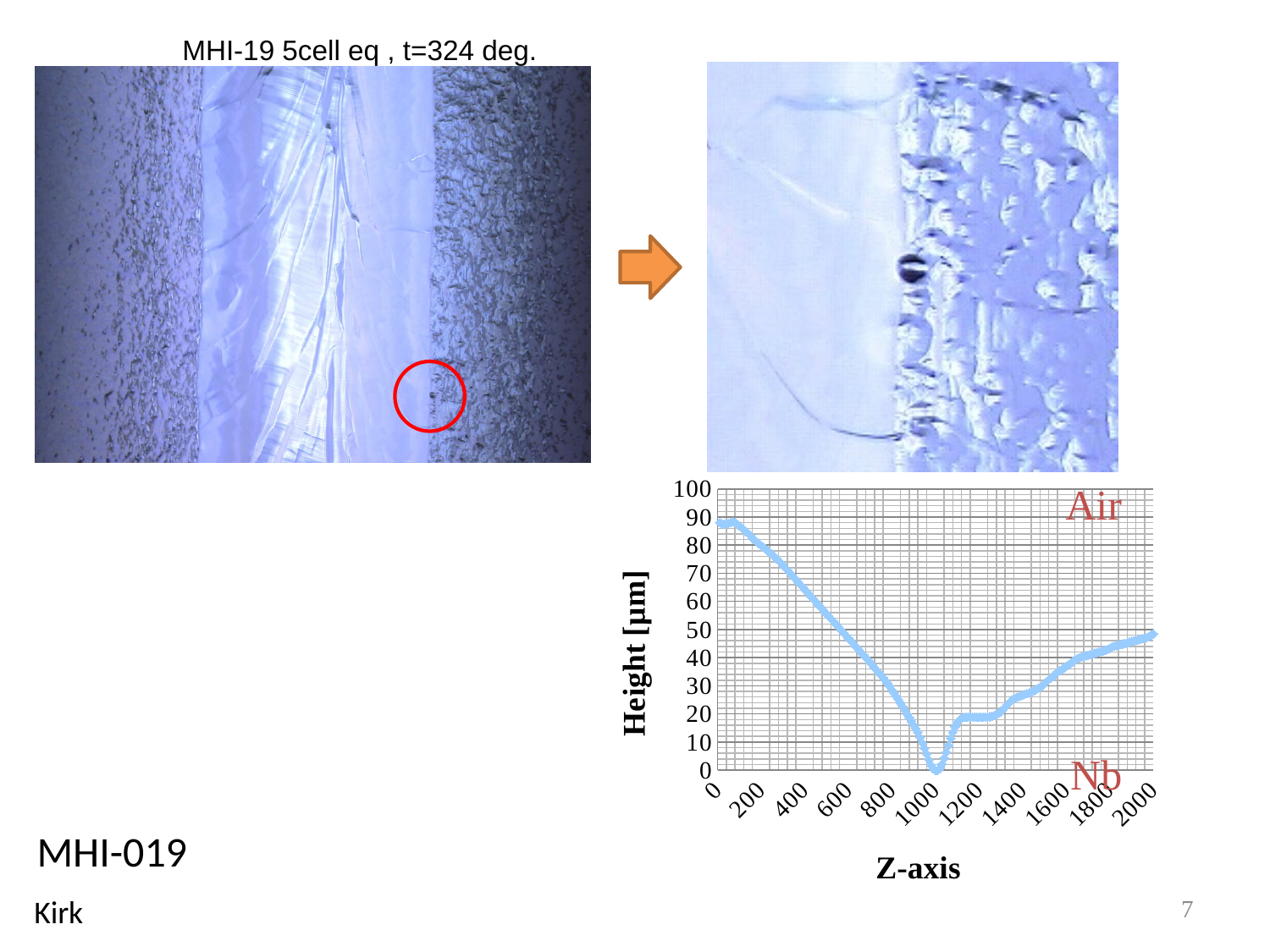
Is the height at Z-axis = 1000 greater or less than 20? less Does the height rise or fall as the Z-axis goes from 1200 to 2000? rise Is the height at Z-axis = 1200 greater or less than 30? less Which is larger, the height at Z-axis = 0 or the height at Z-axis = 2000? Z-axis = 0 What is the label of the vertical axis of the chart? Height [µm] What kind of chart is shown on the slide? scatter chart Does the height rise or fall as the Z-axis goes from 0 to 1000? fall What is the label of the horizontal axis of the chart? Z-axis Is the height at Z-axis = 2000 greater or less than 40? greater How many data series are plotted in the chart? 1